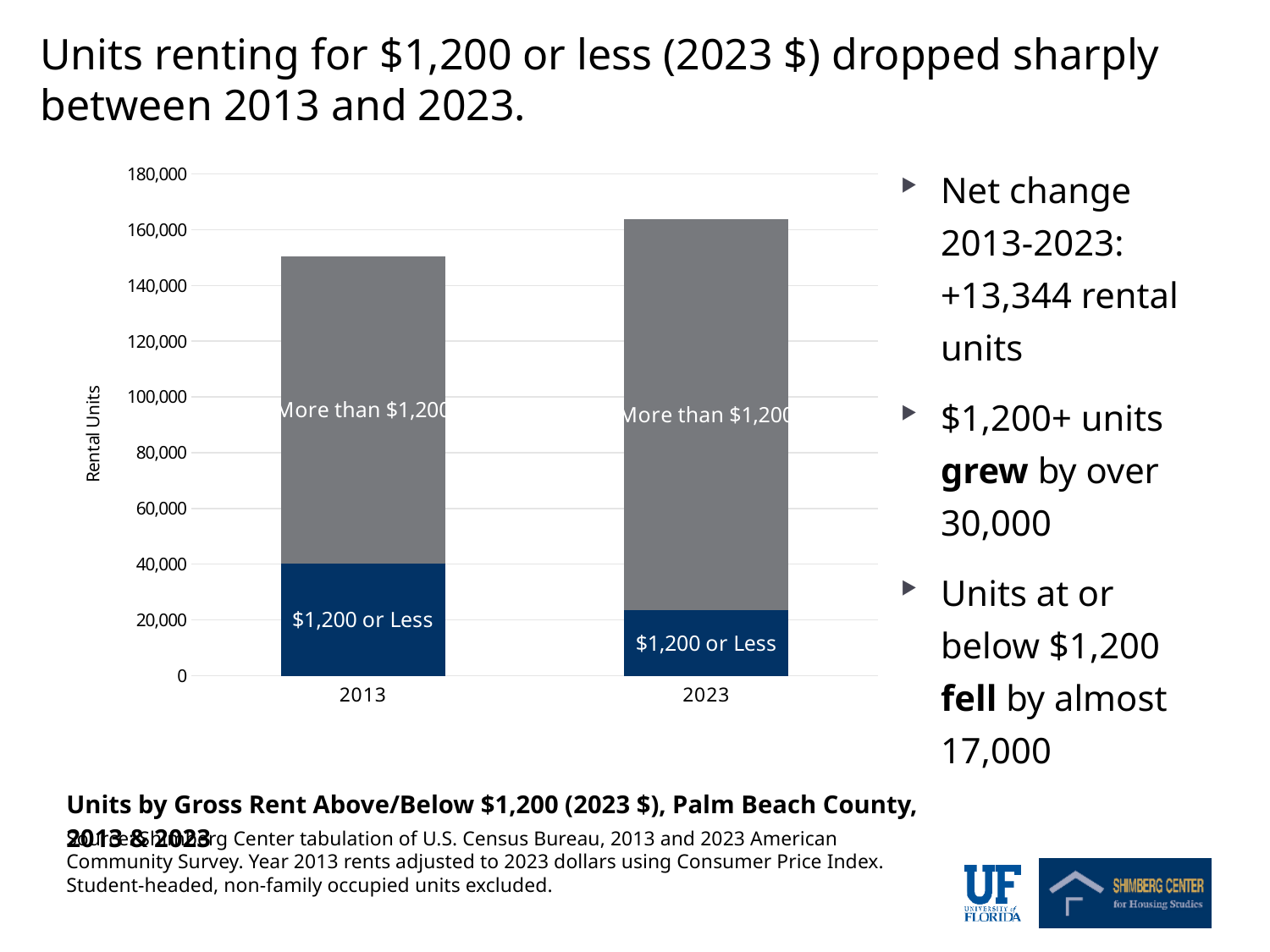
Is the "$1,200 or Less" segment larger in 2013 or in 2023? 2013 Does the total number of rental units rise or fall from 2013 to 2023? rise Is the total height of the 2013 bar greater or less than 140,000? greater Is the "$1,200 or Less" segment for 2013 greater or less than 60,000? less What is the label on the y axis of the chart? Rental Units Does the "$1,200 or Less" segment rise or fall from 2013 to 2023? fall What kind of chart is shown on the slide? stacked bar chart Is the total height of the 2023 bar greater or less than 180,000? less How many rent categories are stacked in each bar of the chart? 2 How many years are shown on the x axis of the chart? 2 Which year has the taller total bar, 2013 or 2023? 2023